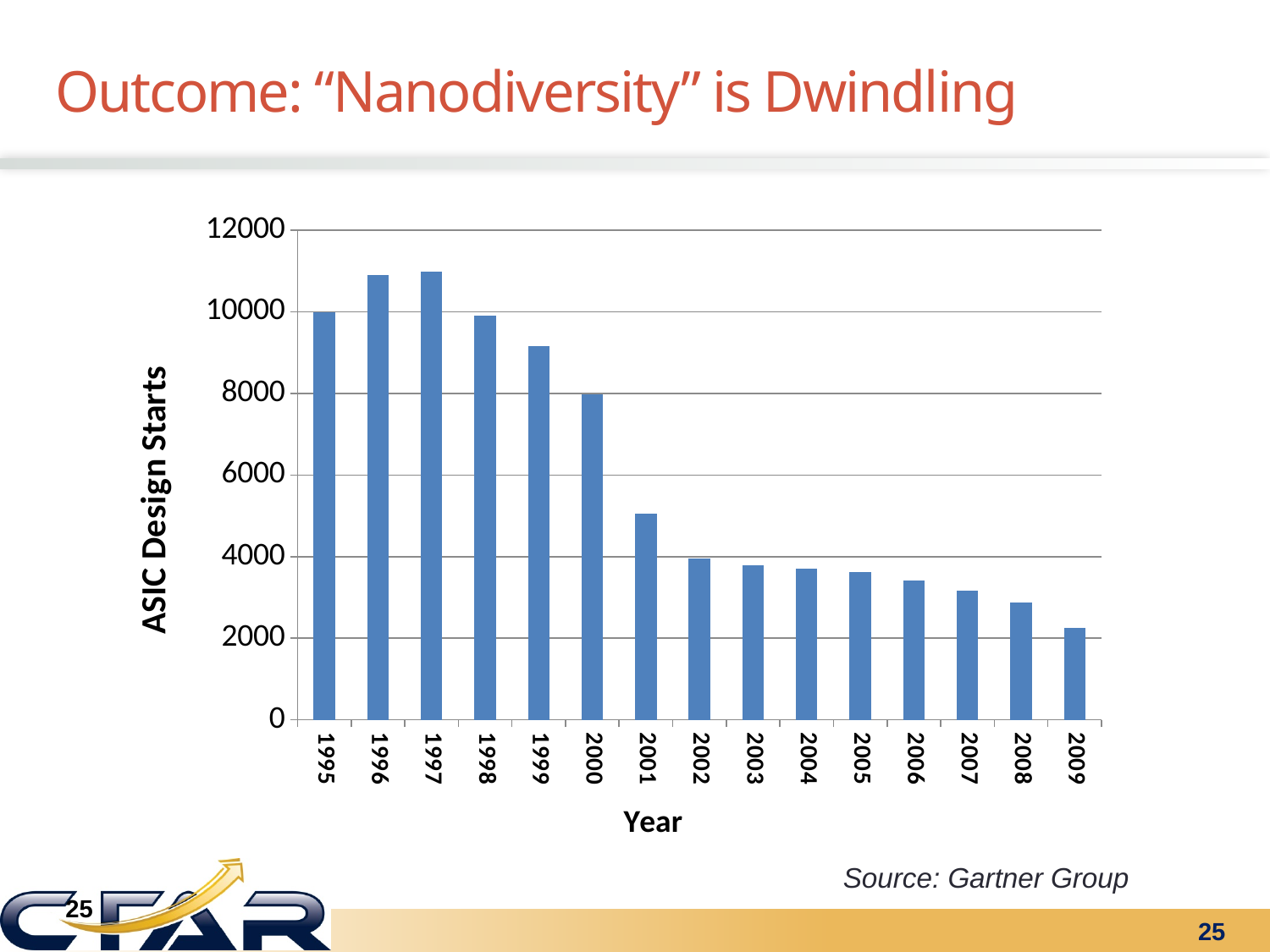
What kind of chart is shown on the slide? Bar chart How many years are plotted on the x axis? 15 Do ASIC design starts generally rise or fall from 1997 to 2009? Fall What is the label on the vertical axis of the chart? ASIC Design Starts Is the value for 2001 greater or less than 4000? greater What is the value of ASIC design starts for 1995? 10000 Which year has the lowest number of ASIC design starts? 2009 Which year has more ASIC design starts, 1998 or 1999? 1998 Which year has more ASIC design starts, 2001 or 2002? 2001 Is the value for 1999 greater or less than 8000? greater